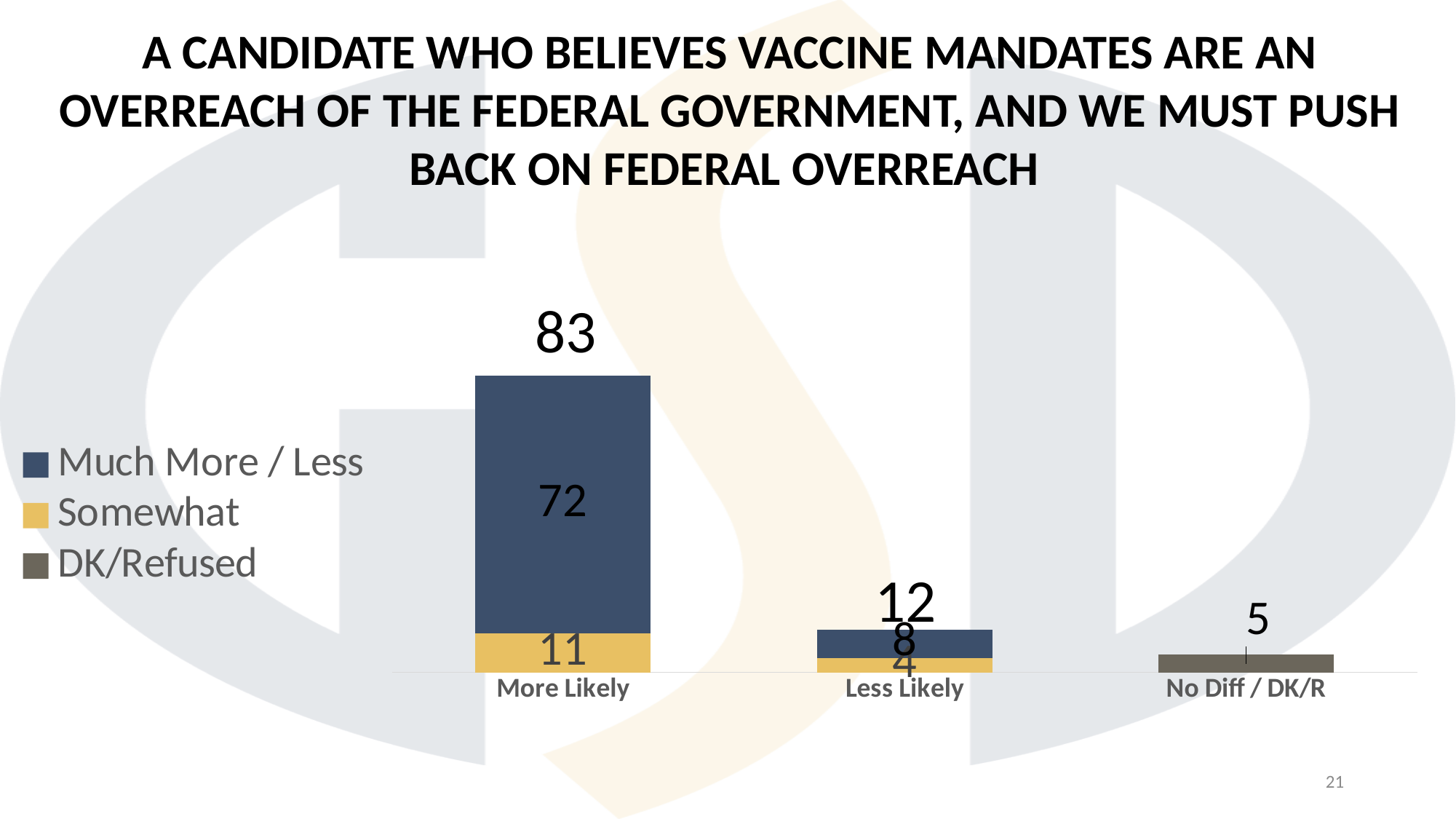
Which category has the lowest total? No Diff / DK/R What is the Somewhat value for More Likely? 11 What is the value for No Diff / DK/R? 5 What is the Somewhat value for Less Likely? 4 What is the Much More / Less value for Less Likely? 8 What is the Much More / Less value for More Likely? 72 What kind of chart is shown on the slide? Stacked bar chart Which category has the highest total? More Likely How many series does the legend list? 3 What is the total shown above the Less Likely bar? 12 What is the total shown above the More Likely bar? 83 What is the difference between the Much More / Less values for More Likely and Less Likely? 64